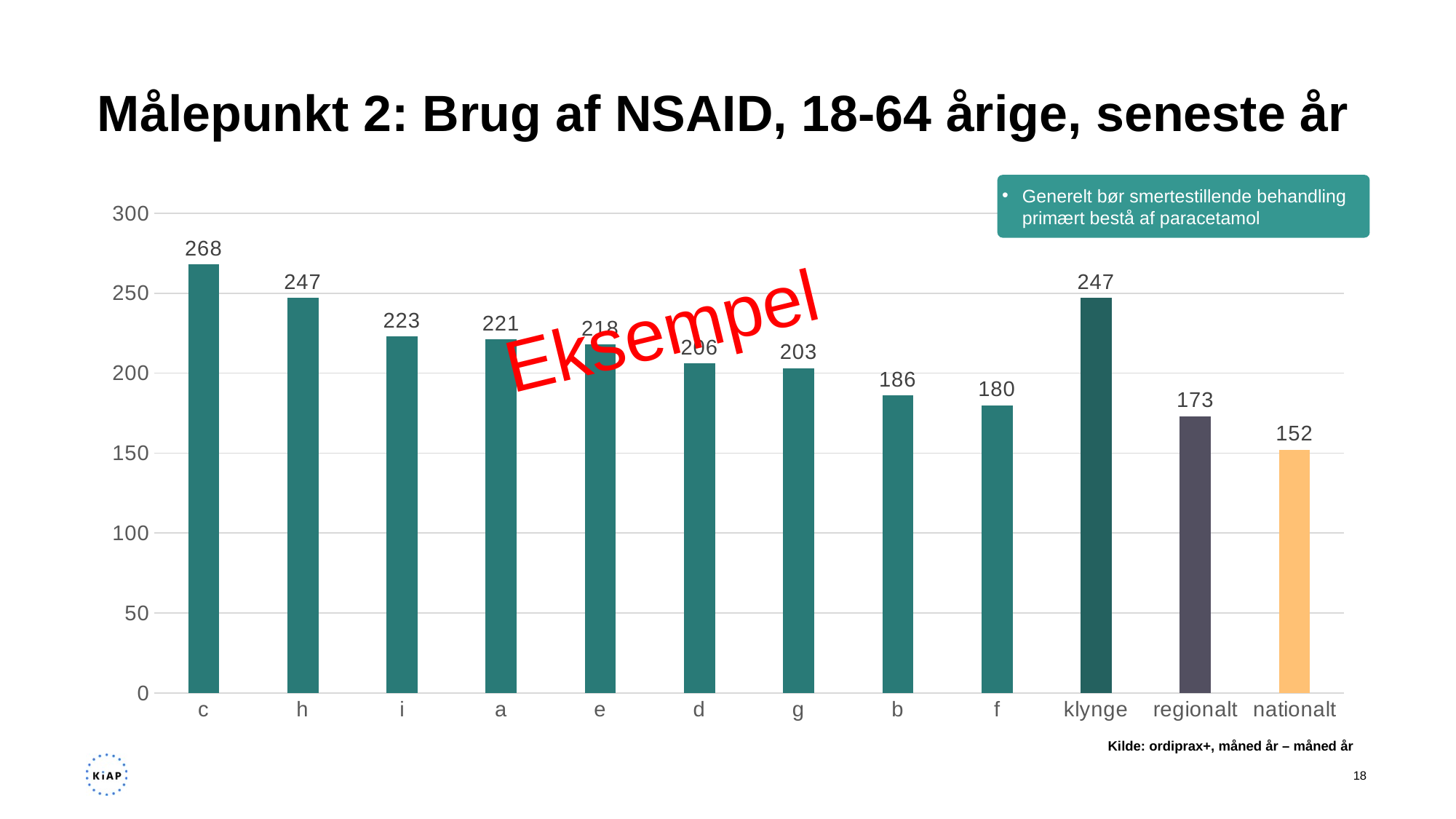
Which is larger, the value for i or the value for b? i What is the value for regionalt? 173 What is the difference between the values for c and nationalt? 116 What is the value for category c? 268 Is the value for f greater or less than 200? less What is the value for nationalt? 152 How many categories are shown on the x axis? 12 What is the value for klynge? 247 Which category has the highest value? c Which category has the lowest value? nationalt What kind of chart is shown on the slide? bar chart What is the difference between the values for klynge and regionalt? 74